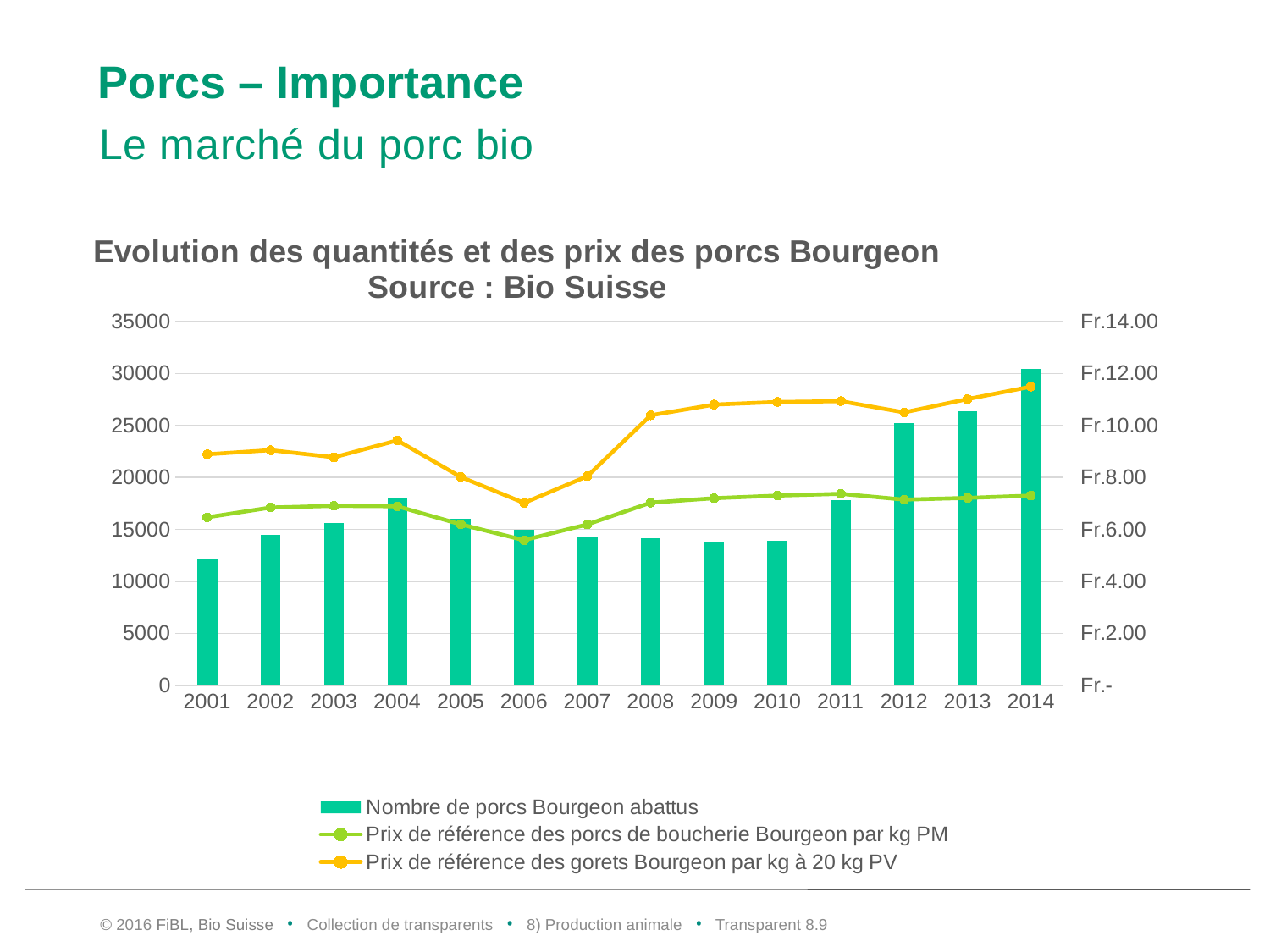
How many series does the legend list? 3 Is the reference price of Bourgeon piglets (gorets) in 2006 greater or less than Fr.8.00? less What kind of chart is shown on the slide? A combined bar and line chart In which year is the number of Bourgeon pigs slaughtered (Nombre de porcs Bourgeon abattus) highest? 2014 Does the number of Bourgeon pigs slaughtered rise or fall between 2011 and 2014? rise In which year is the reference price of Bourgeon piglets (gorets) per kg at 20 kg PV lowest? 2006 How many years are shown on the x axis of the chart? 14 Is the number of Bourgeon pigs slaughtered in 2001 greater or less than 15000? less In which year is the number of Bourgeon pigs slaughtered (Nombre de porcs Bourgeon abattus) lowest? 2001 Is the number of Bourgeon pigs slaughtered in 2013 greater or less than 25000? greater Which year has more Bourgeon pigs slaughtered, 2012 or 2013? 2013 According to the chart title, what is the source of the data? Bio Suisse